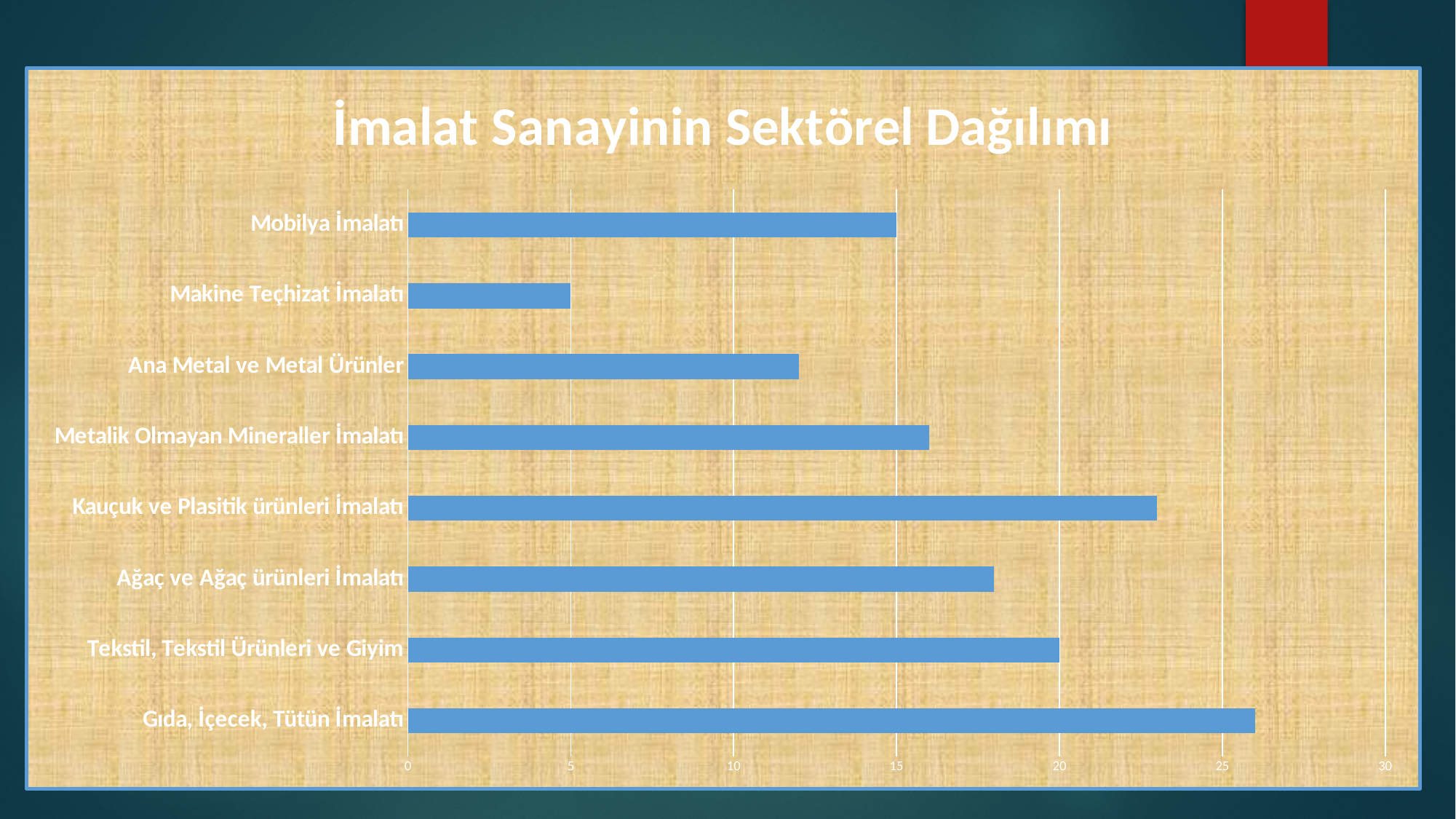
Which sector has the lowest value? Makine Teçhizat İmalatı What is the value for Mobilya İmalatı? 15 Which sector has the highest value? Gıda, İçecek, Tütün İmalatı Is the value for Ağaç ve Ağaç ürünleri İmalatı greater or less than 20? less What is the title of the chart? İmalat Sanayinin Sektörel Dağılımı What kind of chart is shown on the slide? bar chart What is the value for Tekstil, Tekstil Ürünleri ve Giyim? 20 Which is larger, the value for Kauçuk ve Plasitik ürünleri İmalatı or the value for Ağaç ve Ağaç ürünleri İmalatı? Kauçuk ve Plasitik ürünleri İmalatı How many sectors (categories) are plotted in the chart? 8 What is the value for Makine Teçhizat İmalatı? 5 Is the value for Gıda, İçecek, Tütün İmalatı greater or less than 25? greater Is the value for Ana Metal ve Metal Ürünler greater or less than 10? greater